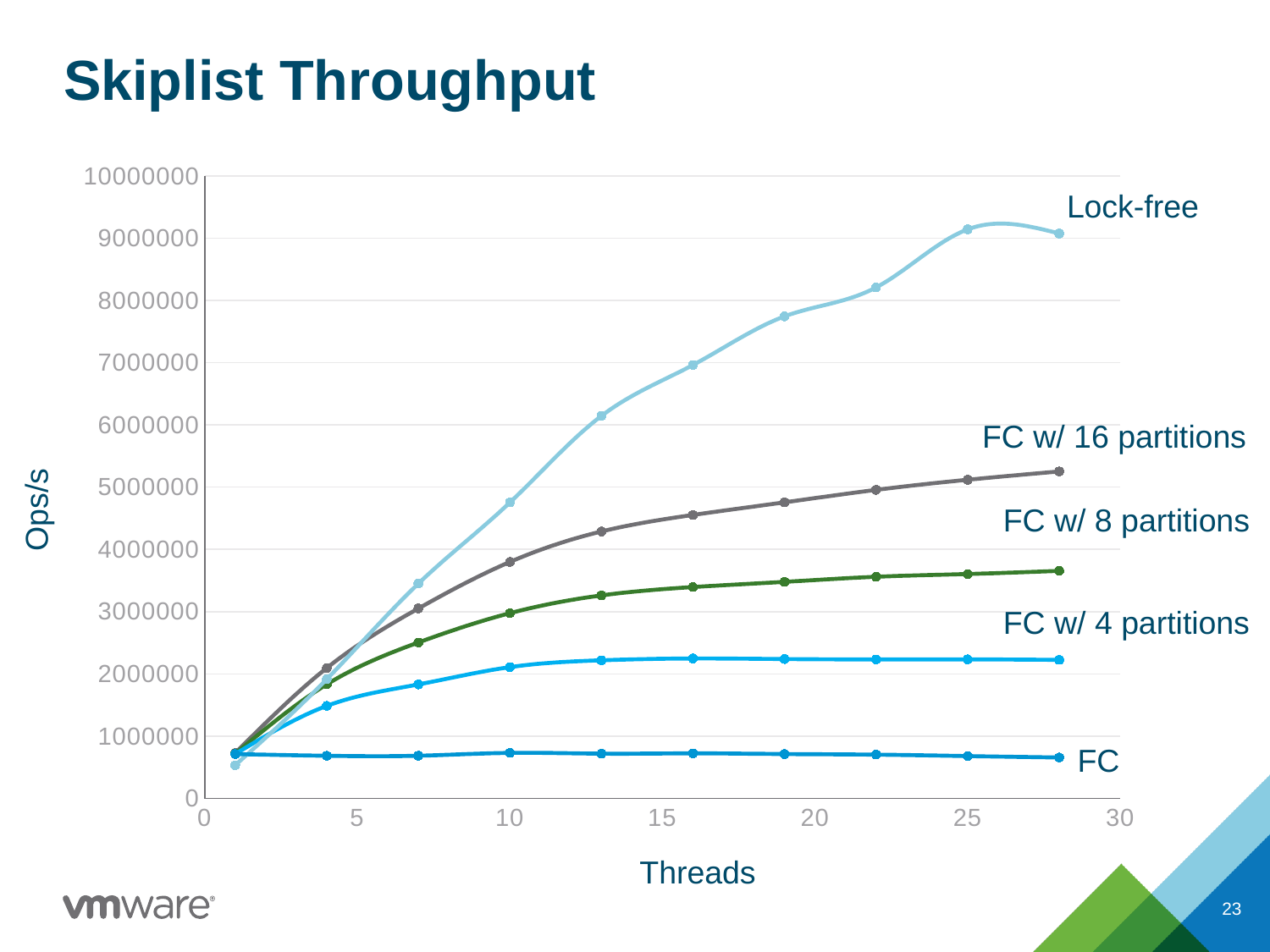
How many data points does the Lock-free series have? 10 Which series has the lowest throughput at 28 threads? FC Is the value for FC w/ 16 partitions at 28 threads greater or less than 5000000? greater Is the value for FC at 28 threads greater or less than 1000000? less At 28 threads, which is larger: FC w/ 8 partitions or FC w/ 4 partitions? FC w/ 8 partitions What kind of chart is shown on the slide? line chart Is the value for FC w/ 8 partitions at 28 threads greater or less than 4000000? less How many series are plotted in the Skiplist Throughput chart? 5 Does the Lock-free series generally rise or fall as the number of threads increases from 1 to 25? rise What is the label of the y axis? Ops/s Which series has the highest throughput at 28 threads? Lock-free